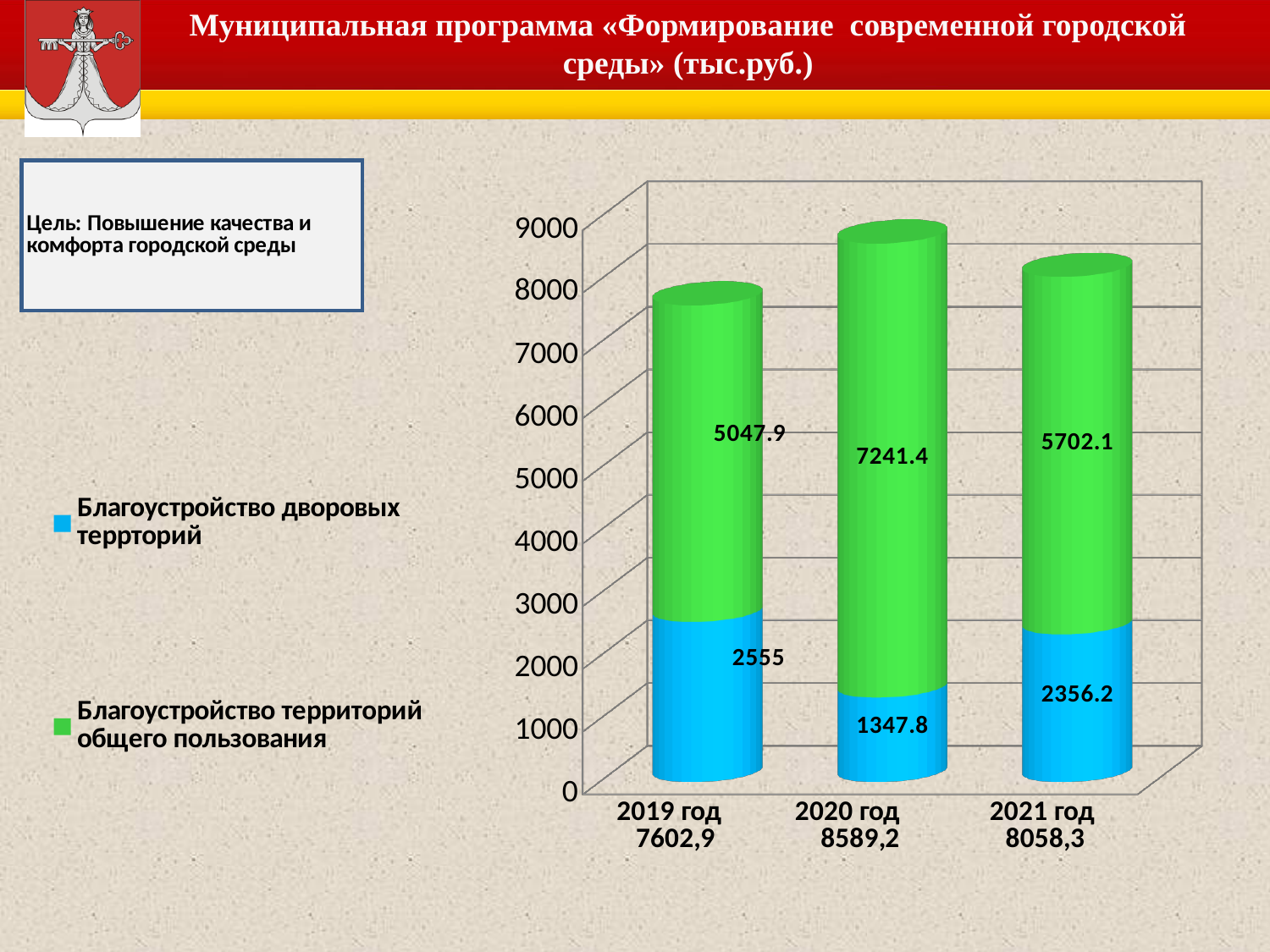
What is the total of the stacked bar for 2020 год? 8589,2 What is the value for 'Благоустройство территорий общего пользования' in 2021 год? 5702.1 What is the value for 'Благоустройство территорий общего пользования' in 2020 год? 7241.4 What is the difference between the 'Благоустройство территорий общего пользования' values for 2020 год and 2019 год? 2193.5 What is the value for 'Благоустройство дворовых терpторий' in 2021 год? 2356.2 In which year is the value for 'Благоустройство территорий общего пользования' highest? 2020 год How many years are shown on the x axis? 3 What kind of chart is shown on the slide? Stacked bar chart What is the value for 'Благоустройство дворовых терpторий' in 2019 год? 2555 How many series does the legend list? 2 In which year is the value for 'Благоустройство дворовых терpторий' lowest? 2020 год Which is larger: the 'Благоустройство дворовых терpторий' value for 2019 год or for 2021 год? 2019 год